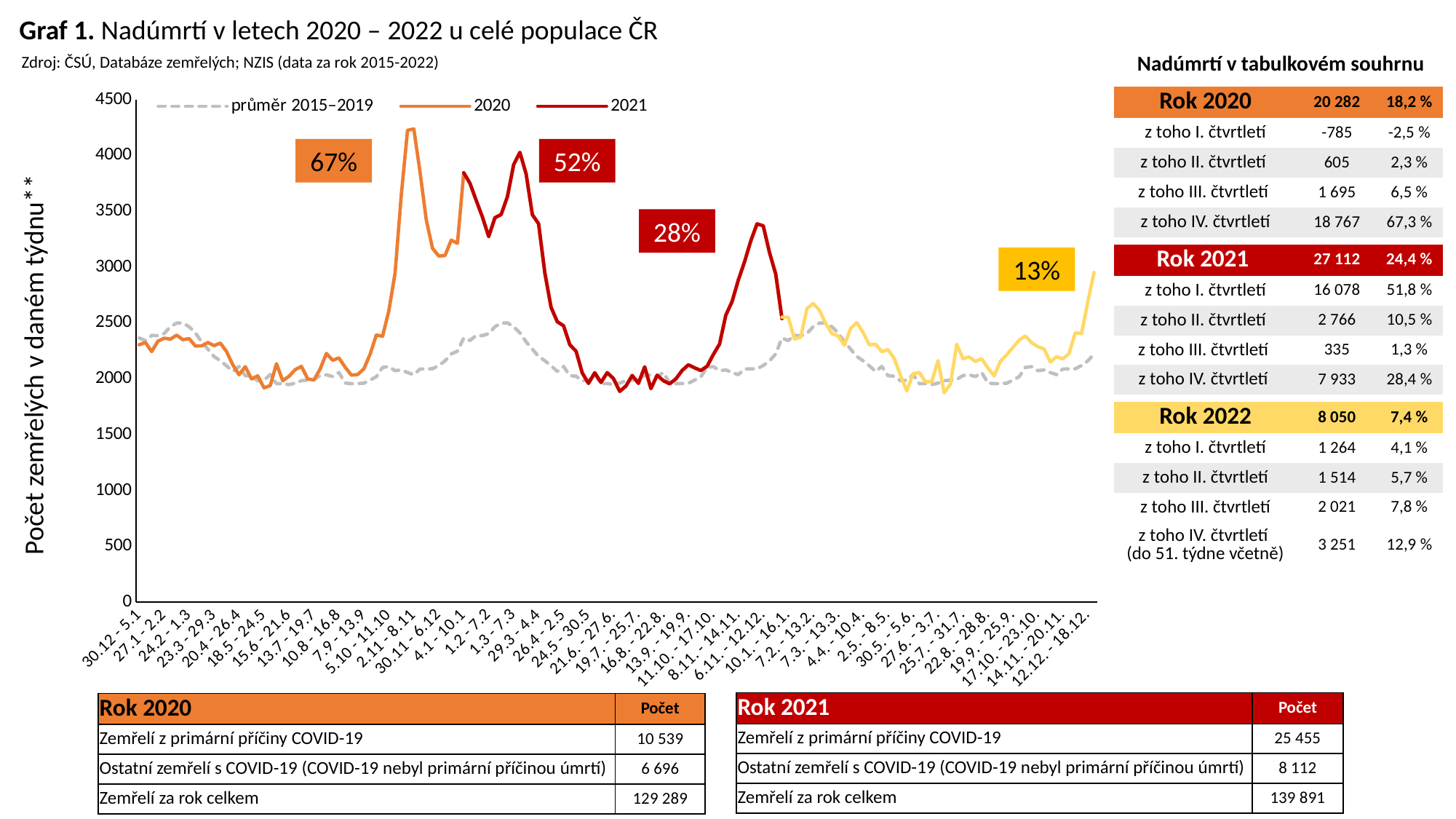
Is the highest point of the průměr 2015–2019 line greater or less than 3000? less Is the peak of the 2020 line (around week 2.11 - 8.11) greater or less than 4000? greater Is the value of the 2020 line at week 30.12 - 5.1 greater or less than 3000? less Which series in the chart legend is drawn as a dashed grey line? průměr 2015–2019 Does the 2021 line rise or fall between week 1.3 - 7.3 and week 21.6 - 27.6? fall What percentage is shown in the yellow label at the right side of the chart? 13% Does the 2020 line rise or fall between week 5.10 - 11.10 and week 2.11 - 8.11? rise What kind of chart is Graf 1? line chart What percentage is shown in the orange label placed above the 2020 peak in the chart? 67% How many series does the legend of the chart list? 3 What is the highest value shown on the vertical axis of the chart? 4500